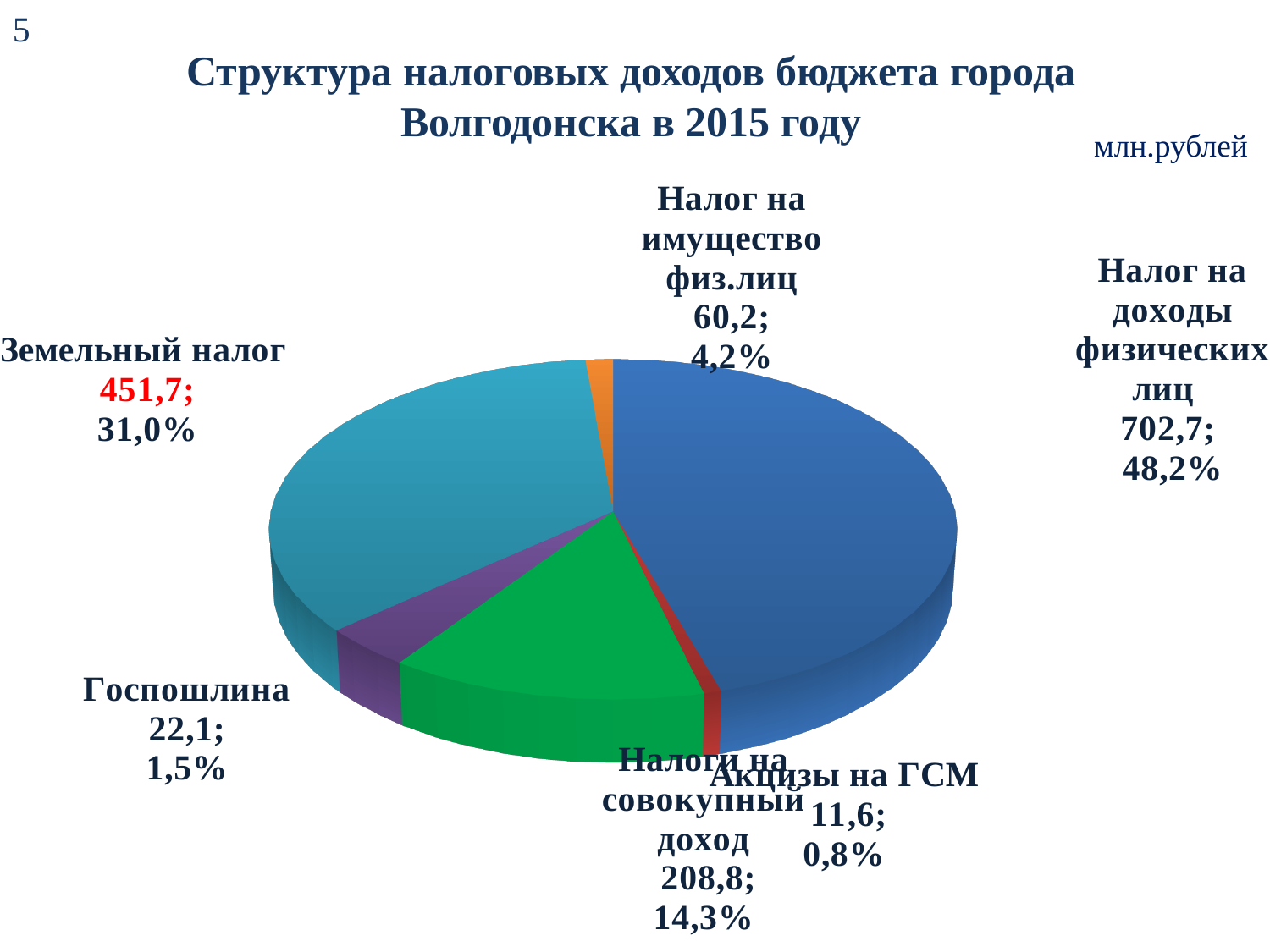
What is the value for Земельный налог? 451,7 Which category has the largest slice of the pie? Налог на доходы физических лиц What share of the pie does Налоги на совокупный доход represent? 14,3% What unit of measurement is indicated for the chart values? млн.рублей What is the difference between the values for Налог на доходы физических лиц and Земельный налог? 251,0 What is the value for Акцизы на ГСМ? 11,6 What is the value for Налог на доходы физических лиц? 702,7 What share of the pie does Налог на имущество физ.лиц represent? 4,2% Which is larger, the value for Госпошлина or the value for Налог на имущество физ.лиц? Налог на имущество физ.лиц What kind of chart is shown on the slide? pie chart How many slices does the pie chart have? 6 Which category has the smallest slice of the pie? Акцизы на ГСМ